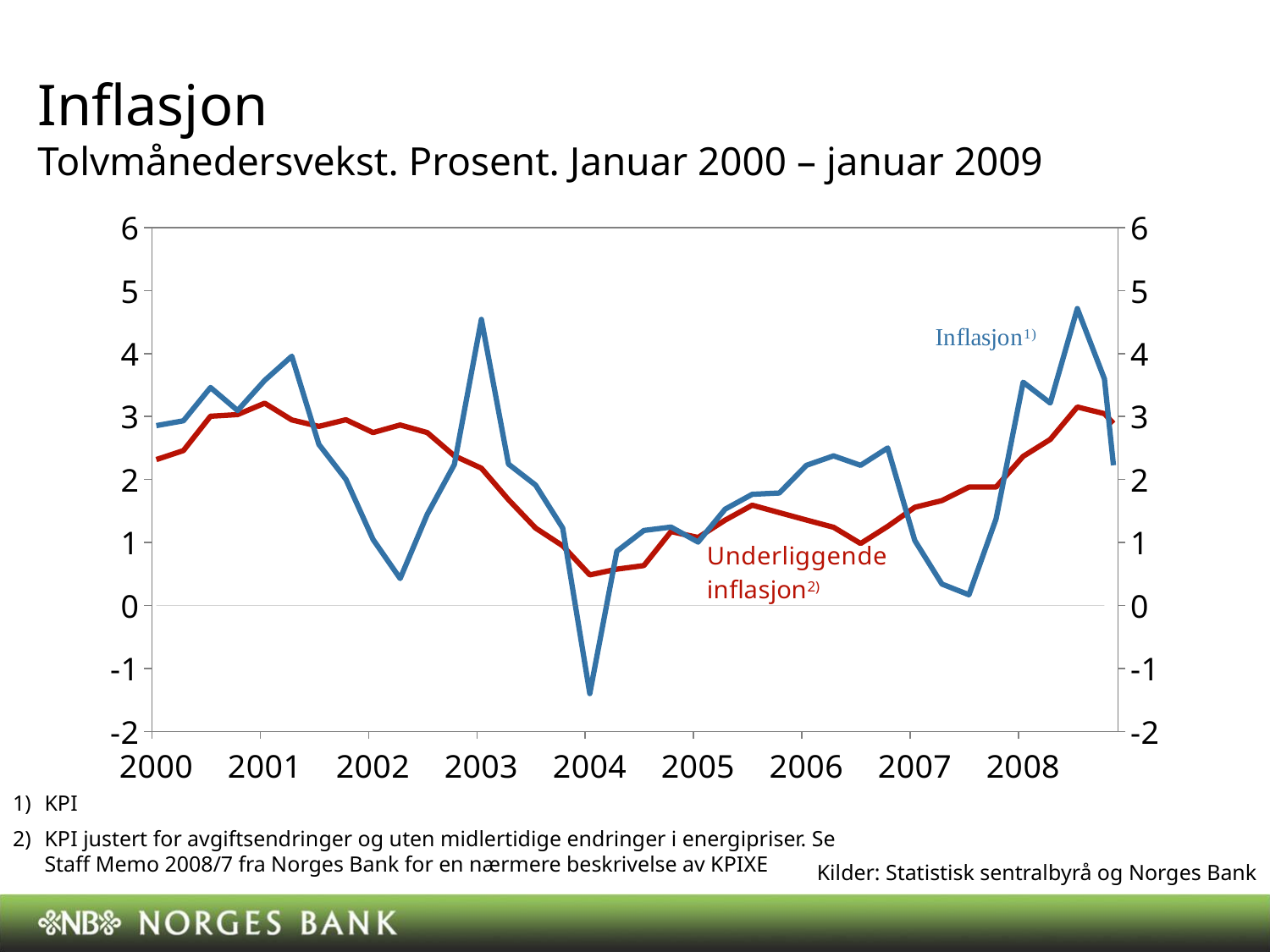
At the start of 2004, which series has the higher value, Inflasjon or Underliggende inflasjon? Underliggende inflasjon Is the highest value of Inflasjon in 2008 greater or less than 4? greater Is the peak value of Inflasjon in early 2003 greater or less than 4? greater What is the title of the chart on the slide? Inflasjon Which series reaches the highest value anywhere on the chart? Inflasjon At the start of 2003, which series has the higher value, Inflasjon or Underliggende inflasjon? Inflasjon Is the value of Underliggende inflasjon at the start of 2004 greater or less than 1? less How many series are plotted on the chart? 2 What colour is the line for Inflasjon? Blue What kind of chart is shown on the slide? Line chart Does Underliggende inflasjon rise or fall between 2001 and the start of 2004? Fall